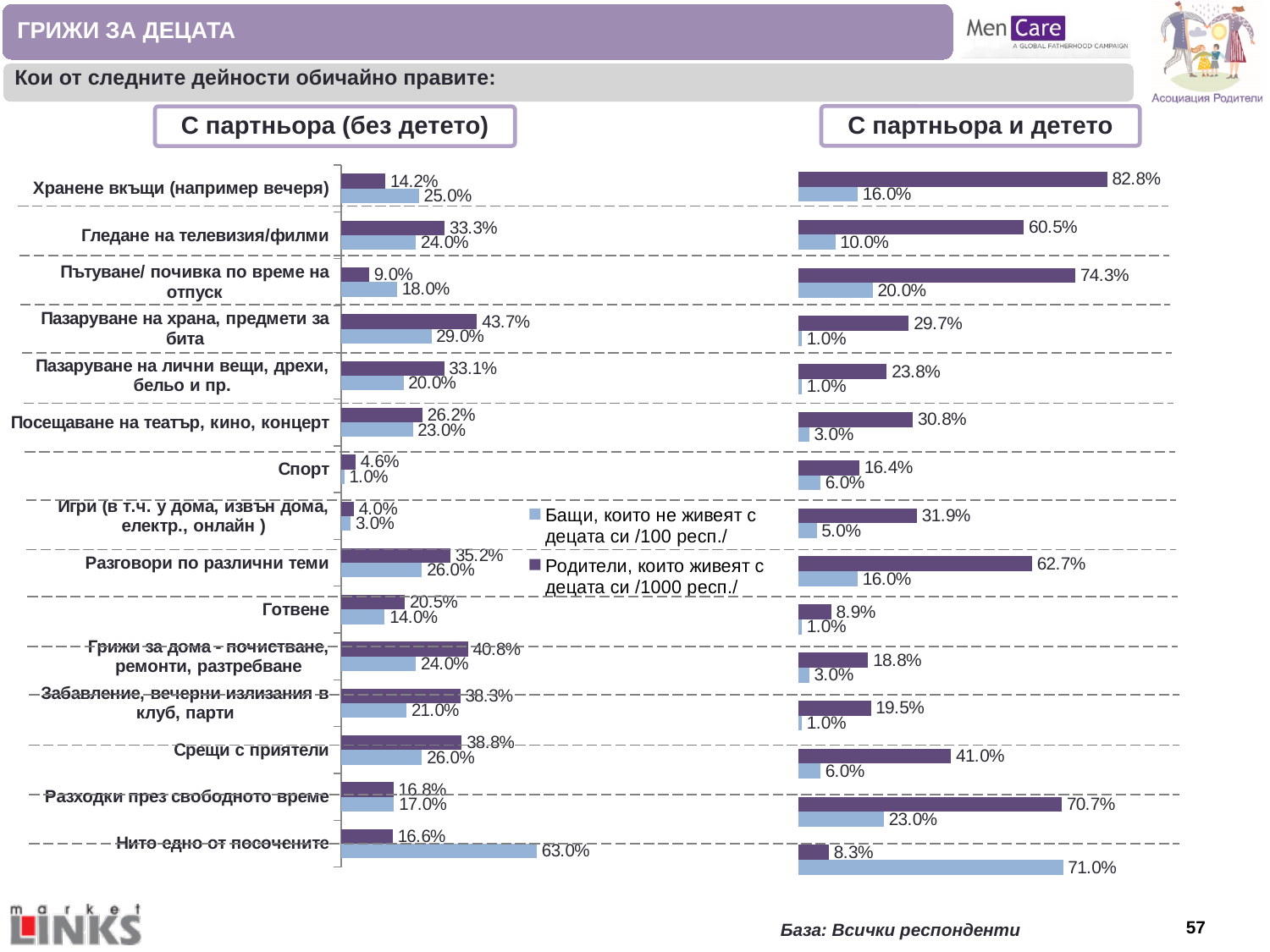
In the chart 'С партньора и детето', what is the value for 'Хранене вкъщи (например вечеря)' for the series 'Бащи, които не живеят с децата си /100 респ./'? 16.0% In the chart 'С партньора (без детето)', what is the value for 'Пазаруване на храна, предмети за бита' for the series 'Родители, които живеят с децата си /1000 респ./'? 43.7% In the chart 'С партньора и детето', what is the value for 'Пътуване/ почивка по време на отпуск' for the series 'Родители, които живеят с децата си /1000 респ./'? 74.3% In the chart 'С партньора и детето', which category has the highest value for the series 'Родители, които живеят с децата си /1000 респ./'? Хранене вкъщи (например вечеря) What is the title of the chart on the right side of the slide? С партньора и детето In the chart 'С партньора (без детето)', which series has the larger value for 'Нито едно от посочените'? Бащи, които не живеят с децата си /100 респ./ How many series does the legend list? 2 In the chart 'С партньора (без детето)', what is the difference between the two series for 'Грижи за дома - почистване, ремонти, разтребване'? 16.8% How many categories are shown in the chart 'С партньора и детето'? 15 In the chart 'С партньора и детето', what is the difference between the two series for 'Разходки през свободното време'? 47.7% In the chart 'С партньора (без детето)', which category has the lowest value for the series 'Бащи, които не живеят с децата си /100 респ./'? Спорт What type of chart is 'С партньора (без детето)'? Bar chart